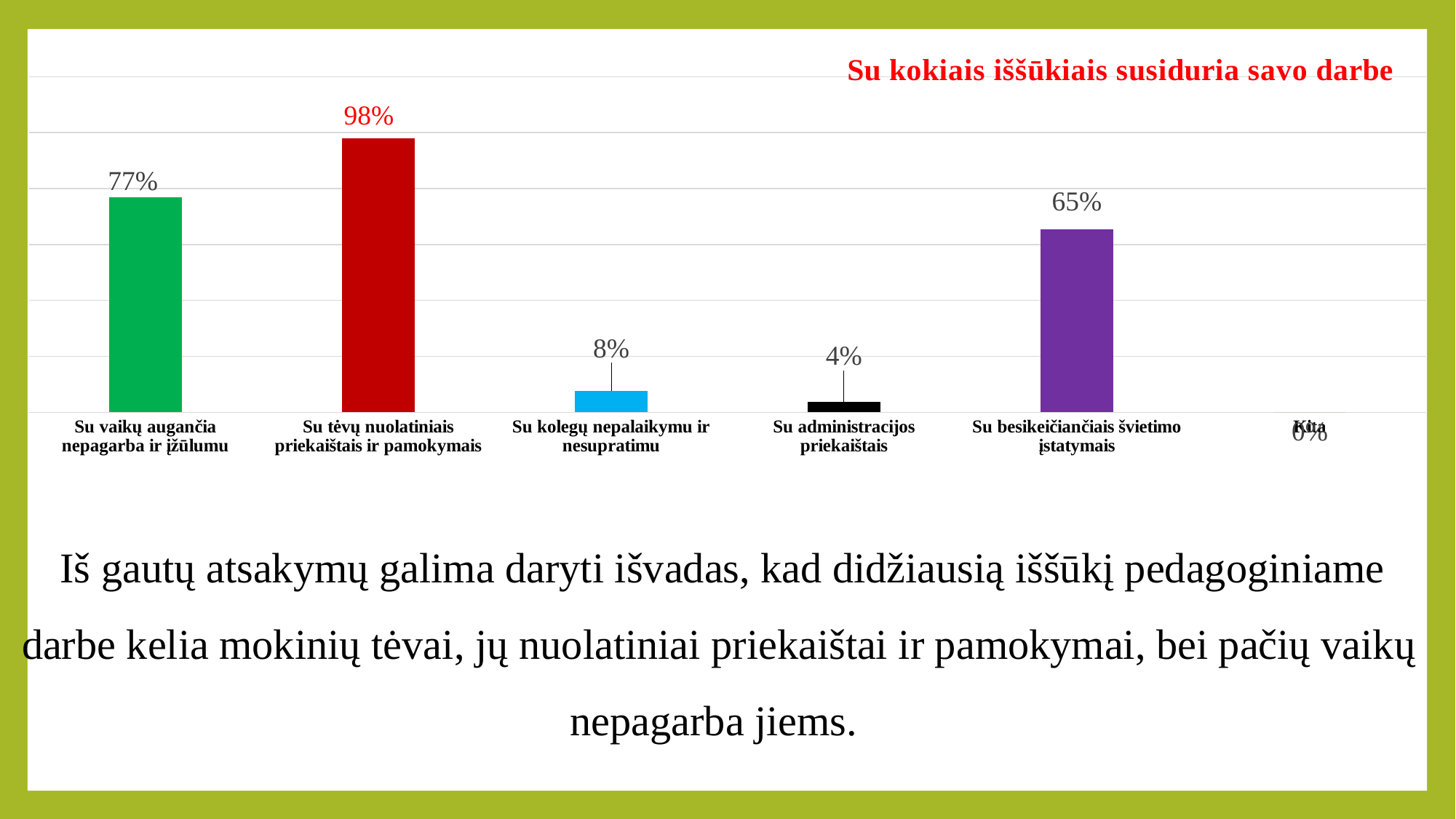
What type of chart is shown on the slide? bar chart Which category has the lowest value? Kita What is the difference between the values for "Su tėvų nuolatiniais priekaištais ir pamokymais" and "Su vaikų augančia nepagarba ir įžūlumu"? 21% What is the value for "Su besikeičiančiais švietimo įstatymais"? 65% What is the title of the chart? Su kokiais iššūkiais susiduria savo darbe What is the value for "Su vaikų augančia nepagarba ir įžūlumu"? 77% What is the value for "Su kolegų nepalaikymu ir nesupratimu"? 8% Which is larger, the value for "Su kolegų nepalaikymu ir nesupratimu" or the value for "Su administracijos priekaištais"? Su kolegų nepalaikymu ir nesupratimu How many categories are shown in the chart? 6 What is the value for "Su tėvų nuolatiniais priekaištais ir pamokymais"? 98% What is the value for "Su administracijos priekaištais"? 4% Which category has the highest value? Su tėvų nuolatiniais priekaištais ir pamokymais